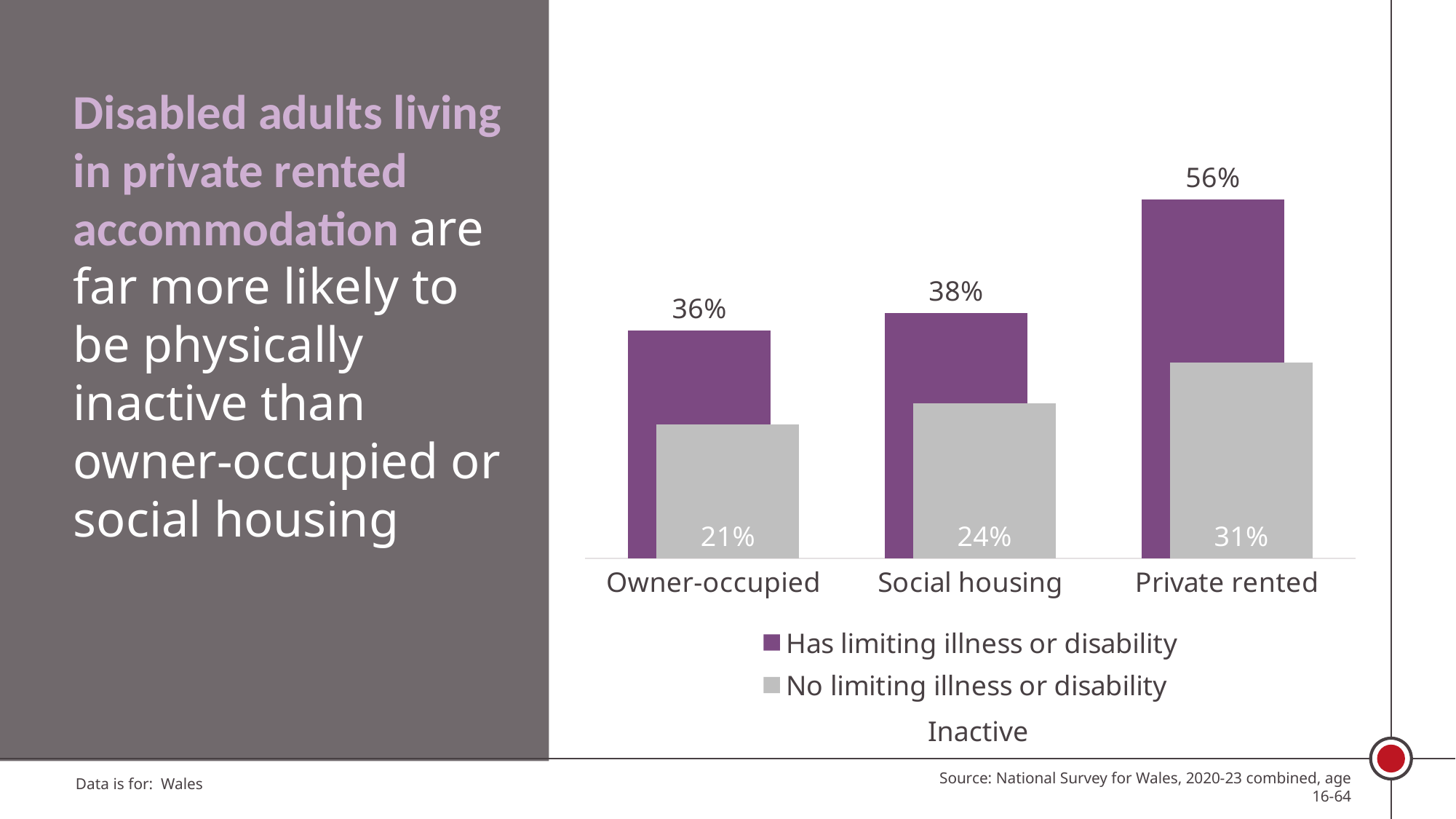
What kind of chart is shown on the slide? Bar chart What is the difference between the 'Has limiting illness or disability' values for Private rented and Owner-occupied? 20% What is the difference between the 'Has limiting illness or disability' and 'No limiting illness or disability' values in the Private rented category? 25% Which housing category has the lowest value for 'No limiting illness or disability'? Owner-occupied What is the value for 'No limiting illness or disability' in the Owner-occupied category? 21% Which housing category has the highest value for 'Has limiting illness or disability'? Private rented What is the value for 'No limiting illness or disability' in the Private rented category? 31% What is the value for 'Has limiting illness or disability' in the Private rented category? 56% How many series does the legend list? 2 How many housing categories are shown on the x axis? 3 What is the value for 'Has limiting illness or disability' in the Social housing category? 38% Which is larger: the 'No limiting illness or disability' value for Social housing or for Owner-occupied? Social housing